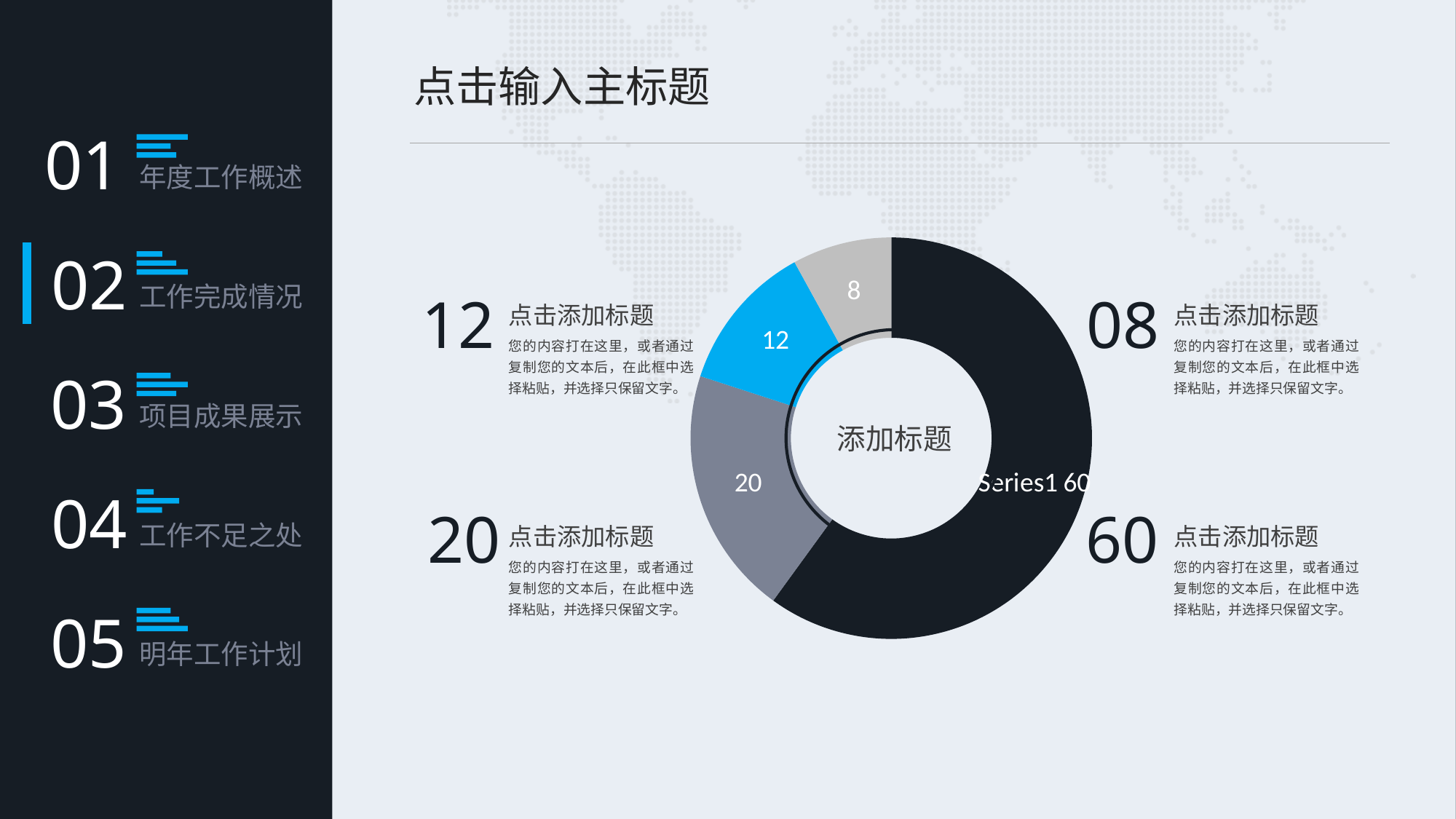
What is the value shown on the blue slice of the doughnut chart? 12 What is the value of the smallest slice in the doughnut chart? 8 What text is shown in the centre of the doughnut chart? 添加标题 What is the total of all the slice values in the doughnut chart? 100 What kind of chart is shown on the slide? doughnut chart What share of the doughnut chart does the slice labelled 20 represent? 20% How many slices does the doughnut chart have? 4 What share of the doughnut chart does the slice labelled 60 represent? 60% Which is larger, the slice labelled 12 or the slice labelled 8? 12 What is the value of the largest slice in the doughnut chart? 60 What is the difference between the largest slice (60) and the slice labelled 20? 40 What is the value shown on the light grey slice of the doughnut chart? 8